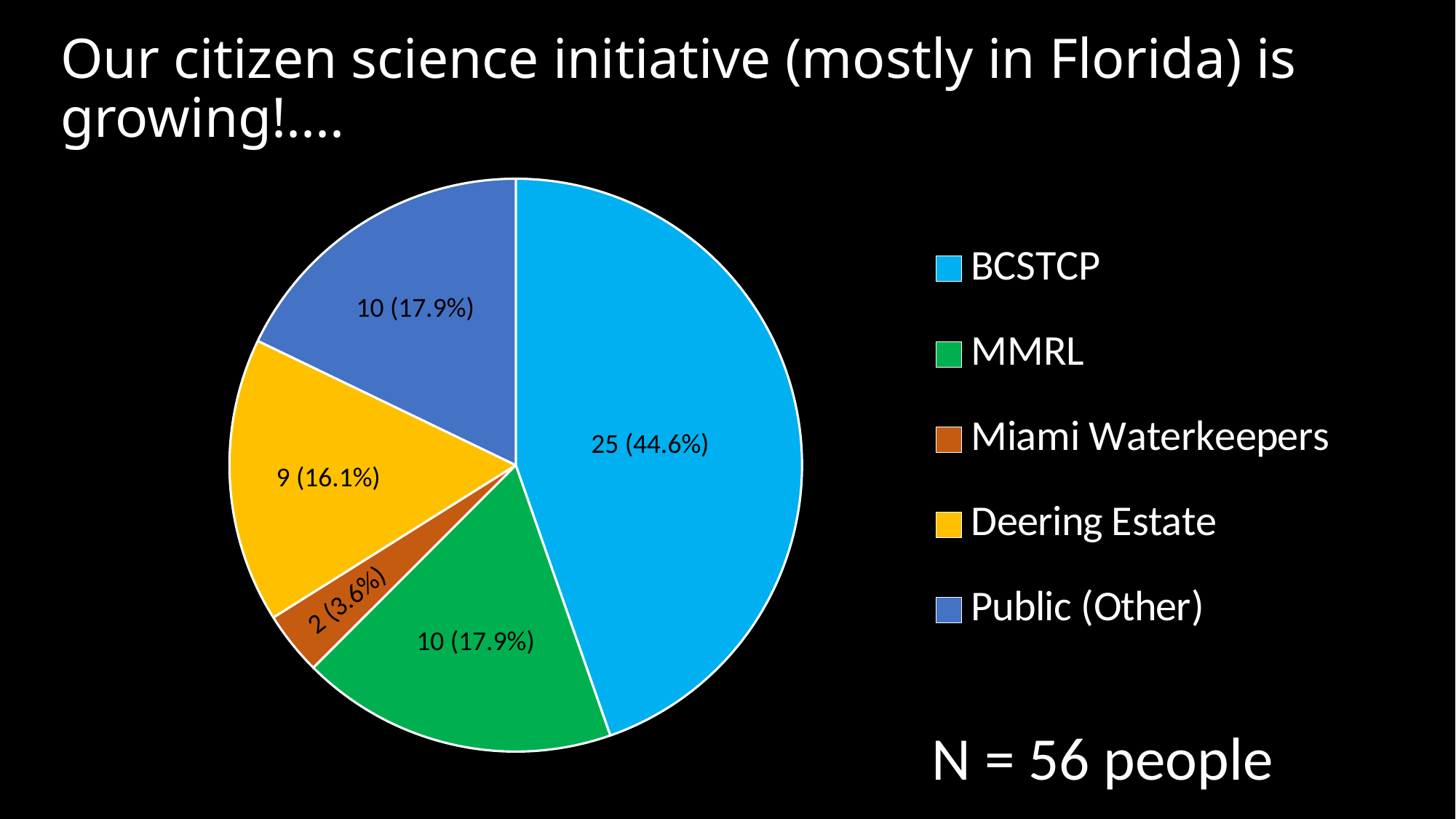
Which category has the largest slice? BCSTCP How many categories does the pie chart have? 5 What is the difference in number of people between BCSTCP and MMRL? 15 What colour is the MMRL slice? green How many people are in the Miami Waterkeepers slice? 2 What percentage share does the BCSTCP slice have? 44.6% Which category has the smallest slice? Miami Waterkeepers What is the total number of people represented in the pie chart? 56 How many people are in the BCSTCP slice? 25 What percentage share does the Deering Estate slice have? 16.1% What kind of chart is shown on the slide? pie chart Which is larger, the Deering Estate slice or the Public (Other) slice? Public (Other)